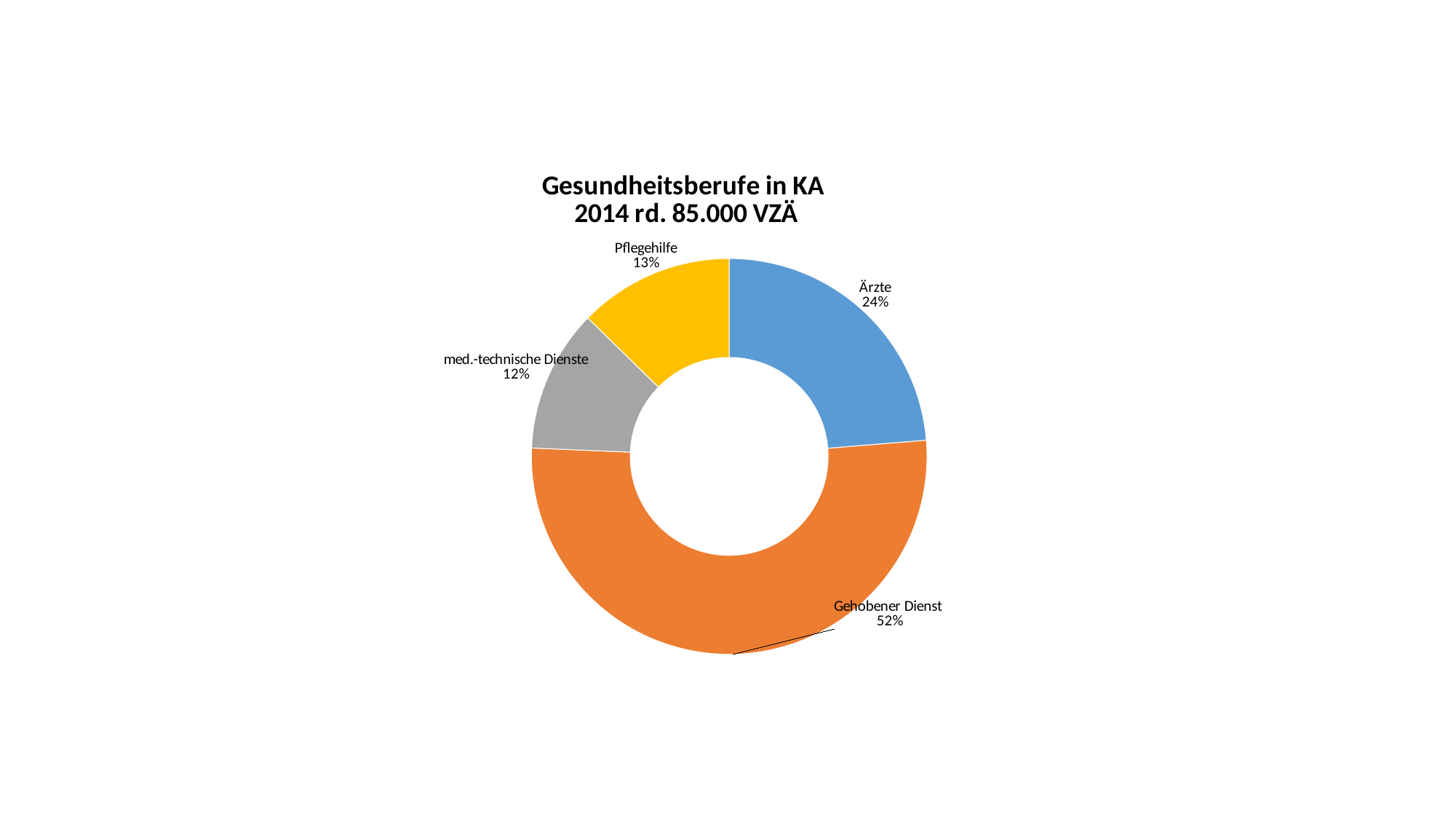
Which category has the largest share? Gehobener Dienst How many categories are shown in the chart? 4 What is the title of the chart? Gesundheitsberufe in KA 2014 rd. 85.000 VZÄ What share of the chart does med.-technische Dienste represent? 12% Which is larger, the share for Ärzte or the share for Pflegehilfe? Ärzte Which category has the smallest share? med.-technische Dienste What is the difference in percentage points between Ärzte and Pflegehilfe? 11 What share of the chart does Gehobener Dienst represent? 52% What share of the chart does Ärzte represent? 24% What kind of chart is shown on the slide? Doughnut (pie) chart What is the difference in percentage points between Gehobener Dienst and Ärzte? 28